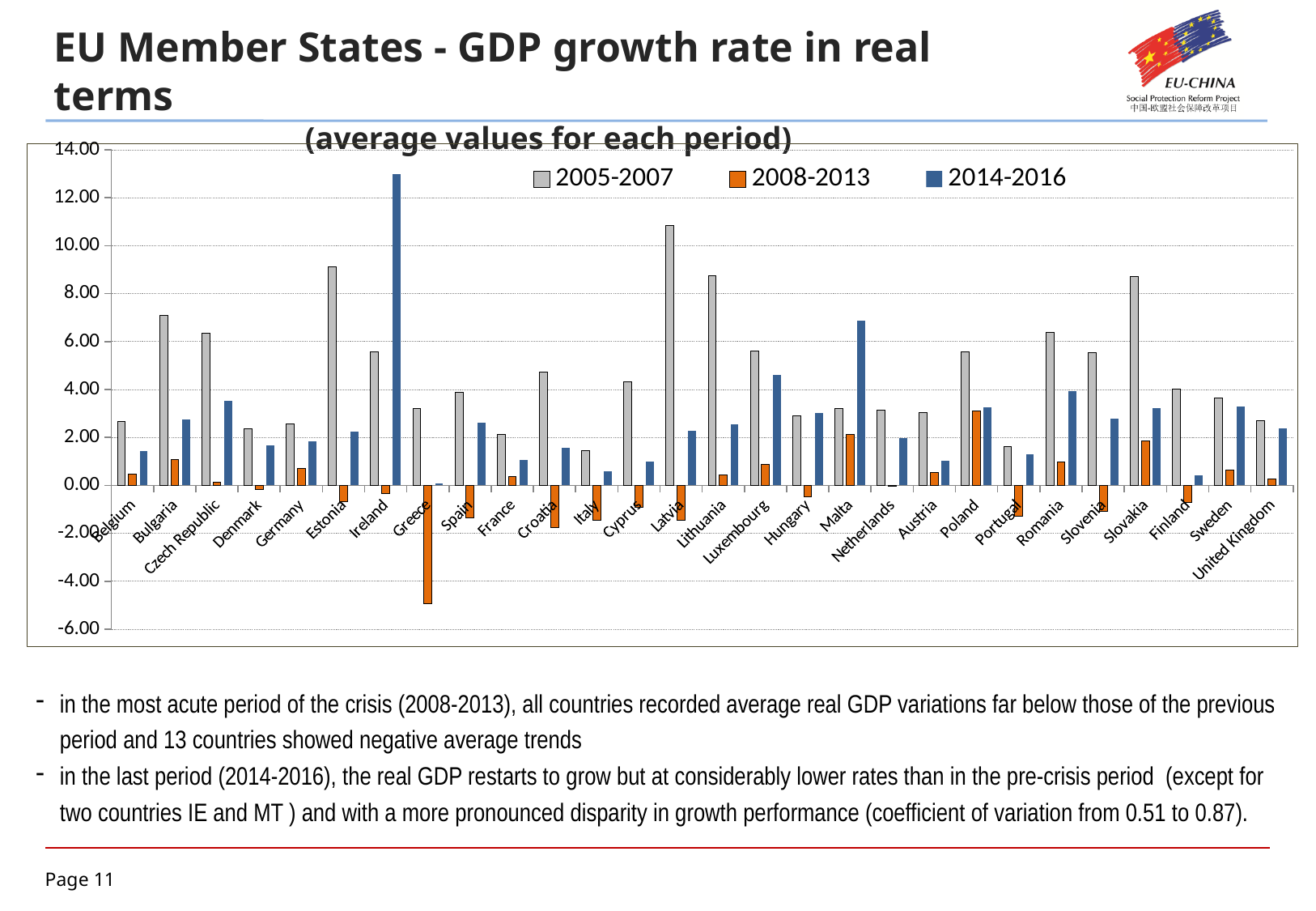
How many countries are shown on the x axis? 28 Is the 2005-2007 value for Latvia greater or less than 10.00? greater Is the 2008-2013 value for Greece greater or less than -4.00? less How many series does the legend list? 3 Which country has the lowest value for the 2008-2013 series? Greece For the 2005-2007 series, which is larger: Latvia or Estonia? Latvia Which country has the highest value for the 2005-2007 series? Latvia What are the three periods listed in the legend? 2005-2007, 2008-2013, 2014-2016 Is the 2014-2016 value for Ireland greater or less than 12.00? greater What kind of chart is shown on the slide? bar chart Which country has the highest value for the 2014-2016 series? Ireland